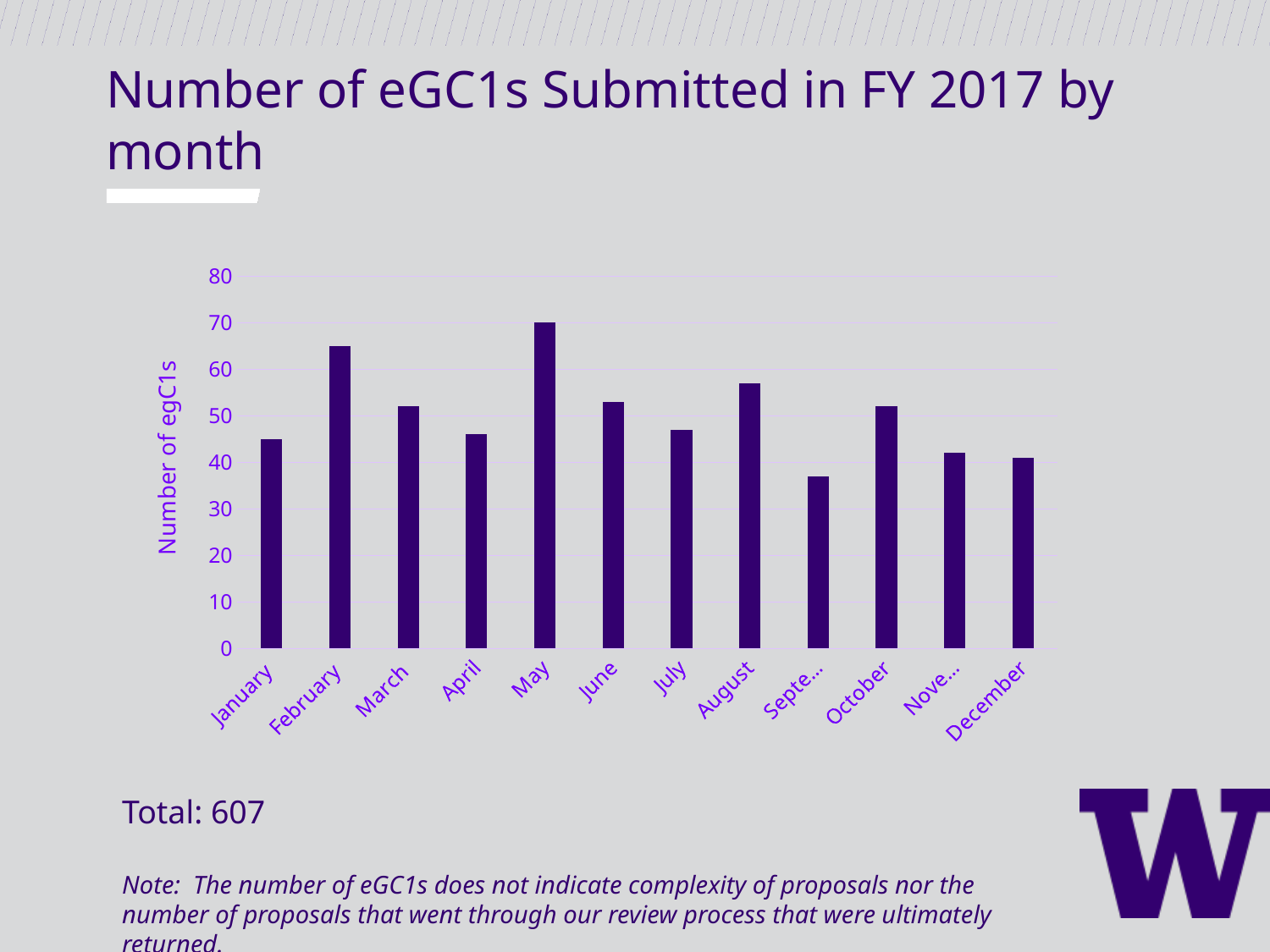
Which month has the highest number of eGC1s submitted? May Is the value for September greater or less than 40? less Is the value for February greater or less than 60? greater What kind of chart is shown on the slide? bar chart Is the value for August greater or less than 50? greater What is the label on the vertical axis of the chart? Number of egC1s Which month has the lowest number of eGC1s submitted? September Which month has more eGC1s submitted, February or March? February How many months (categories) are plotted on the chart? 12 Which month has more eGC1s submitted, November or August? August